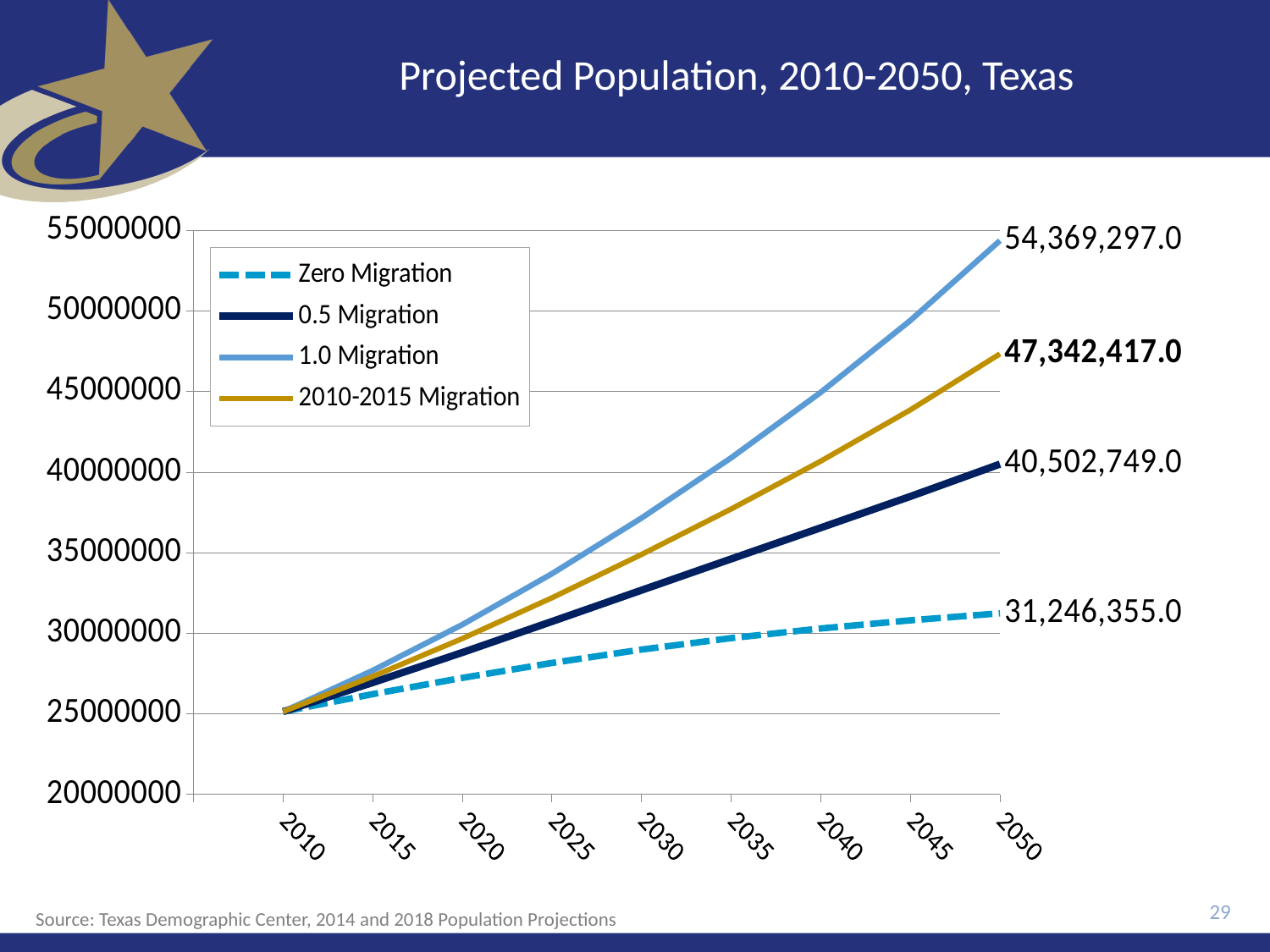
How many series does the legend list? 4 Which scenario has the highest projected population in 2050? 1.0 Migration What is the projected population for the 0.5 Migration scenario in 2050? 40,502,749.0 What is the difference between the 1.0 Migration and Zero Migration projections for 2050? 23,122,942.0 What is the projected population for the Zero Migration scenario in 2050? 31,246,355.0 What is the projected population for the 2010-2015 Migration scenario in 2050? 47,342,417.0 Which is larger in 2050, the 2010-2015 Migration projection or the 0.5 Migration projection? 2010-2015 Migration What is the projected population for the 1.0 Migration scenario in 2050? 54,369,297.0 Is the Zero Migration value for 2030 greater or less than 30000000? less Which scenario has the lowest projected population in 2050? Zero Migration Do the values for the 1.0 Migration series rise or fall from 2010 to 2050? rise What kind of chart is shown on the slide? line chart